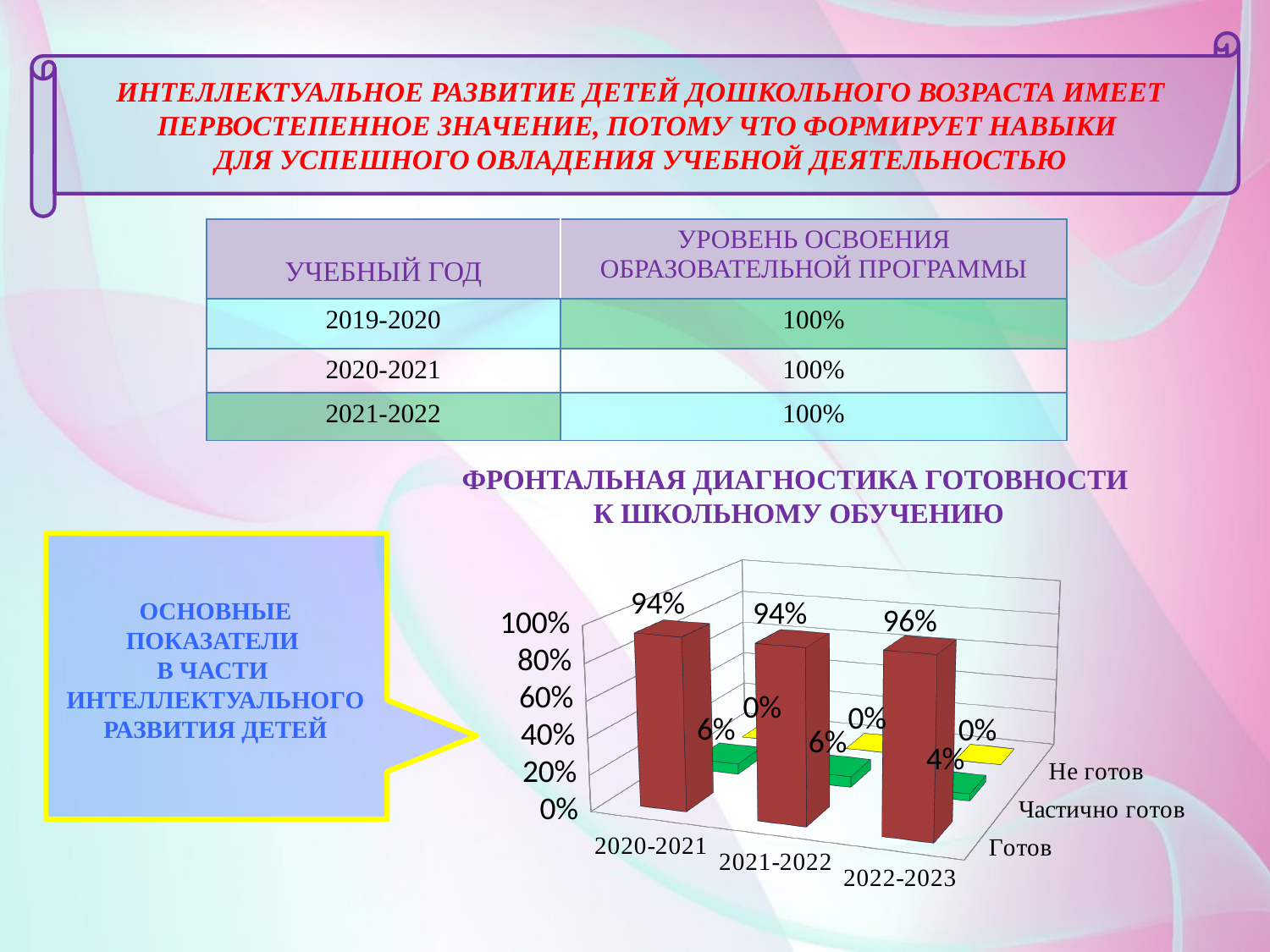
What type of chart is shown under the heading 'ФРОНТАЛЬНАЯ ДИАГНОСТИКА ГОТОВНОСТИ К ШКОЛЬНОМУ ОБУЧЕНИЮ'? bar chart Which is larger: 'Частично готов' in 2020-2021 or 'Частично готов' in 2022-2023? 2020-2021 What is the difference between the 'Готов' values for 2022-2023 and 2021-2022? 2% What is the value for 'Готов' in 2020-2021? 94% What is the value for 'Частично готов' in 2021-2022? 6% In which year is the 'Частично готов' value lowest? 2022-2023 How many series does the chart show? 3 In which year is the 'Готов' value highest? 2022-2023 What is the value for 'Готов' in 2022-2023? 96% How many years (categories) are shown on the chart? 3 What is the value for 'Не готов' in 2020-2021? 0% What is the value for 'Частично готов' in 2022-2023? 4%